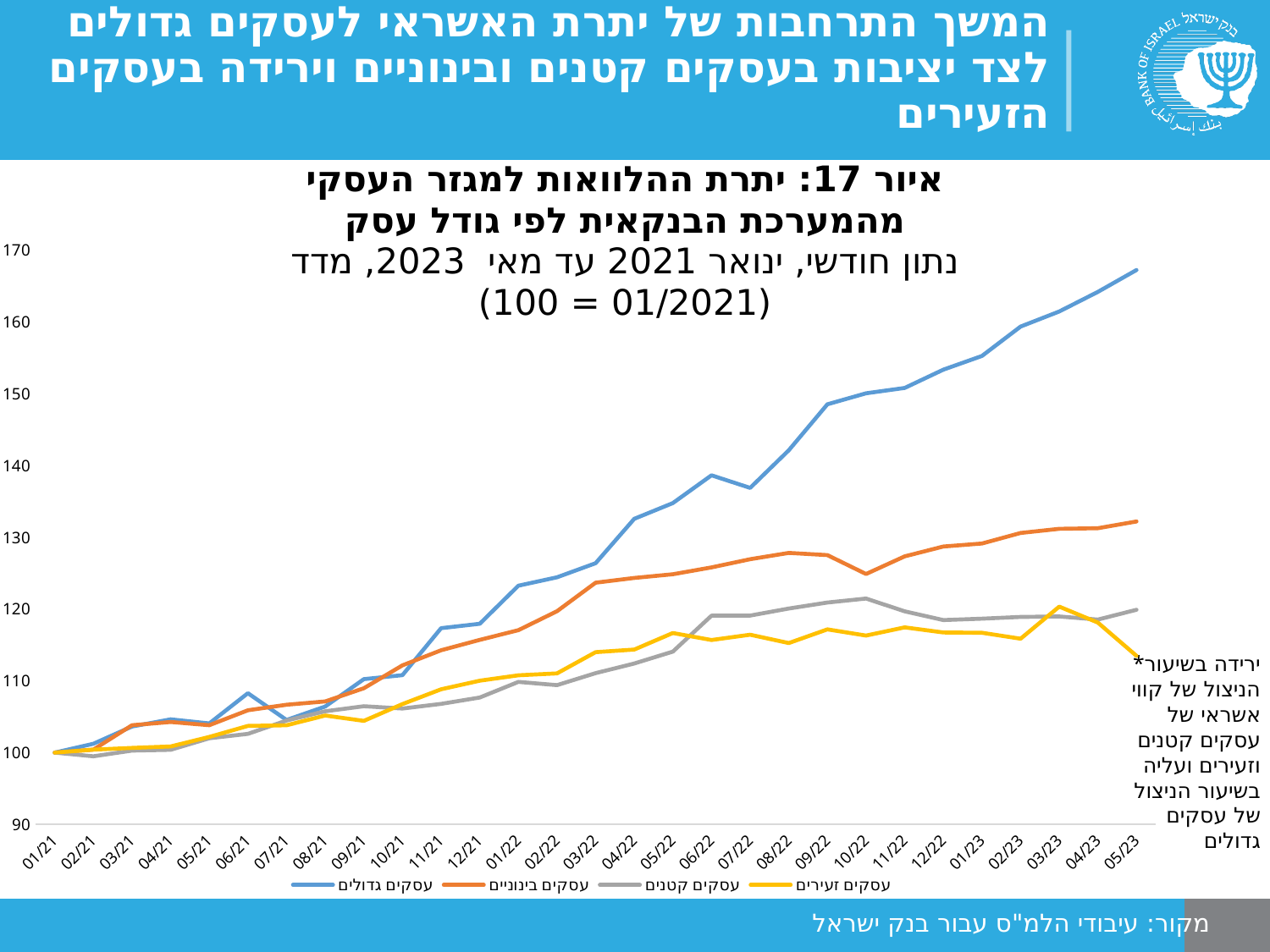
Which series has the highest value at 05/23? עסקים גדולים Does the series עסקים גדולים rise or fall from 01/21 to 05/23? rise How many monthly points are shown on the x axis (from 01/21 to 05/23)? 29 How many series does the legend list? 4 Is the value for עסקים בינוניים at 05/23 greater or less than 120? greater At 05/23, which is larger: the value for עסקים קטנים or the value for עסקים זעירים? עסקים קטנים Is the value for עסקים גדולים at 05/23 greater or less than 160? greater Is the value for עסקים גדולים at 10/22 greater or less than 140? greater What kind of chart is shown on the slide? line chart What base value does the index use, according to the chart subtitle? 01/2021 = 100 Which series has the lowest value at 05/23? עסקים זעירים